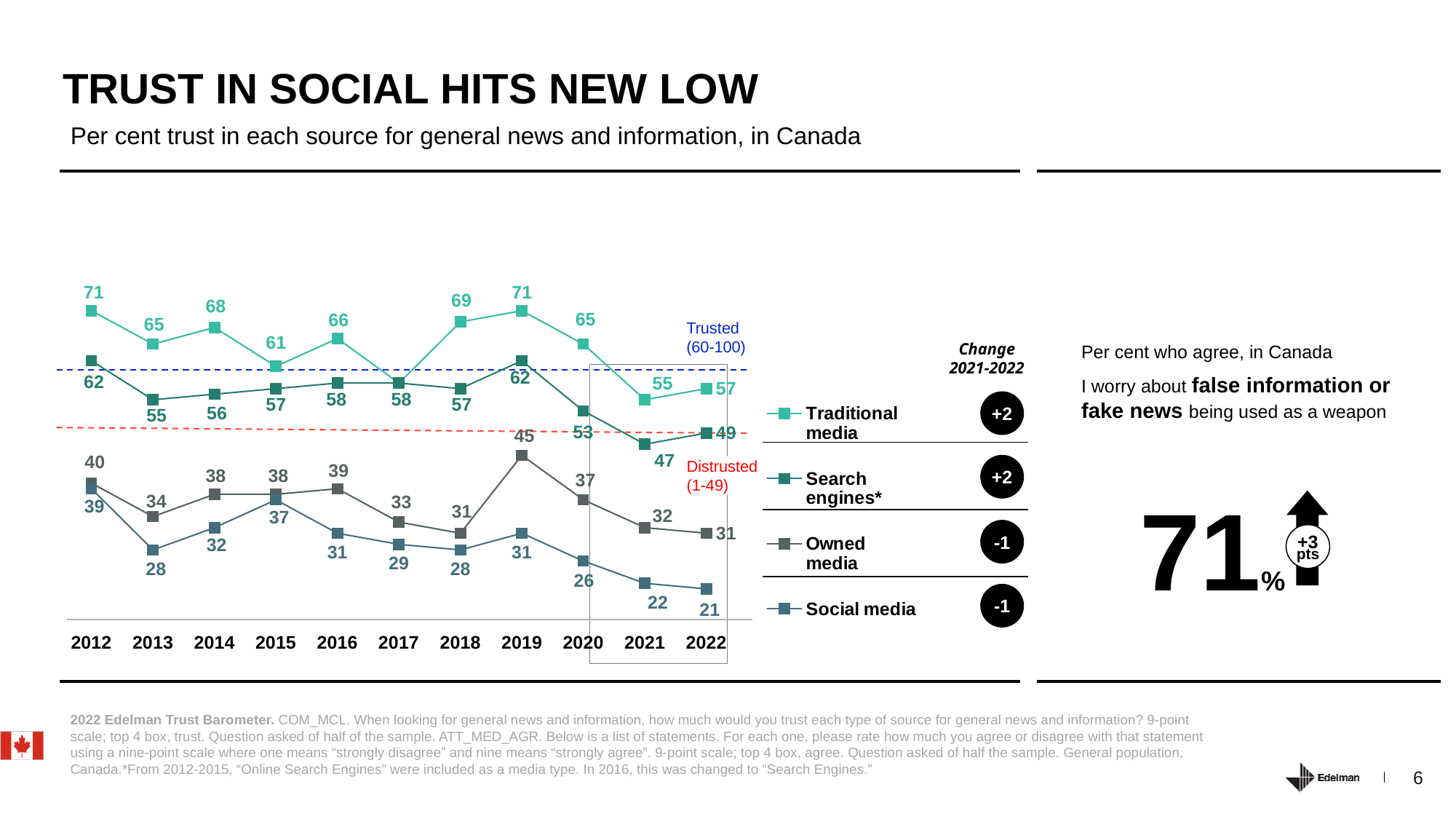
What kind of chart is shown on the slide? line chart In which year is the Traditional media value lowest? 2021 How many series does the chart's legend list? 4 What is the value for Traditional media in 2019? 71 What is the value for Owned media in 2012? 40 Which is larger in 2019, Owned media or Search engines? Search engines What is the difference between Traditional media and Social media in 2022? 36 What is the value for Social media in 2022? 21 Does the Social media value rise or fall from 2019 to 2022? fall In which year is the Social media value highest? 2012 What is the value for Search engines in 2021? 47 How many years are shown along the x axis of the chart? 11